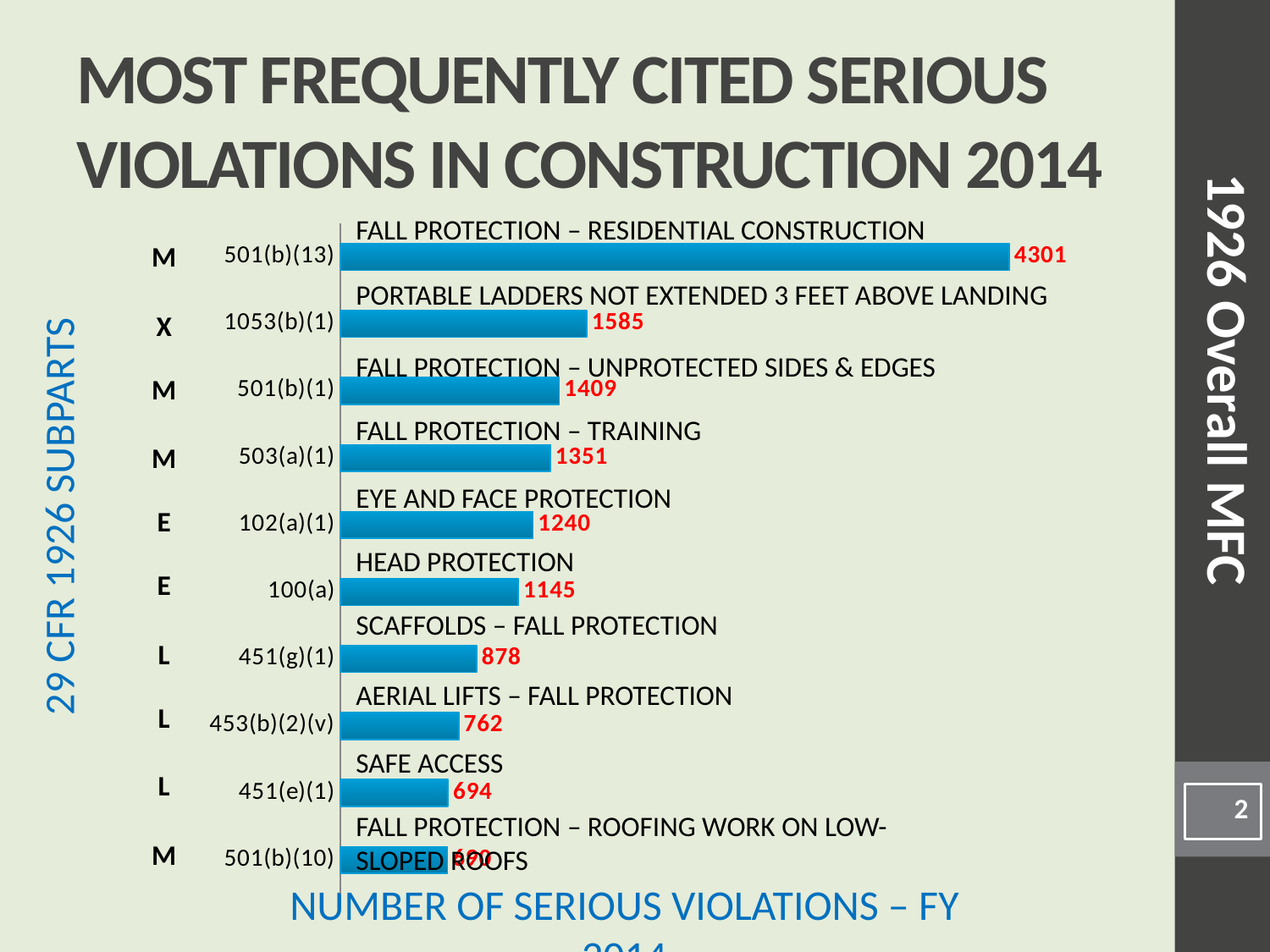
Which has more serious violations: Fall Protection – Training (503(a)(1)) or Aerial Lifts – Fall Protection (453(b)(2)(v))? Fall Protection – Training (503(a)(1)) Which standard has the highest number of serious violations? 501(b)(13) Fall Protection – Residential Construction What is the value shown for 102(a)(1), Eye and Face Protection? 1240 What is the number of serious violations for 501(b)(13), Fall Protection – Residential Construction? 4301 What is the difference between the values for Head Protection (100(a)) and Scaffolds – Fall Protection (451(g)(1))? 267 What type of chart is used on this slide? Bar chart What is the title of the chart on this slide? Most Frequently Cited Serious Violations in Construction 2014 What is the label on the vertical axis of the chart? 29 CFR 1926 Subparts What is the number of serious violations for 1053(b)(1), Portable Ladders Not Extended 3 Feet Above Landing? 1585 What is the value shown for 451(e)(1), Safe Access? 694 What is the difference between the violations for 501(b)(13) and 1053(b)(1)? 2716 How many standards (bars) are shown in the chart? 10